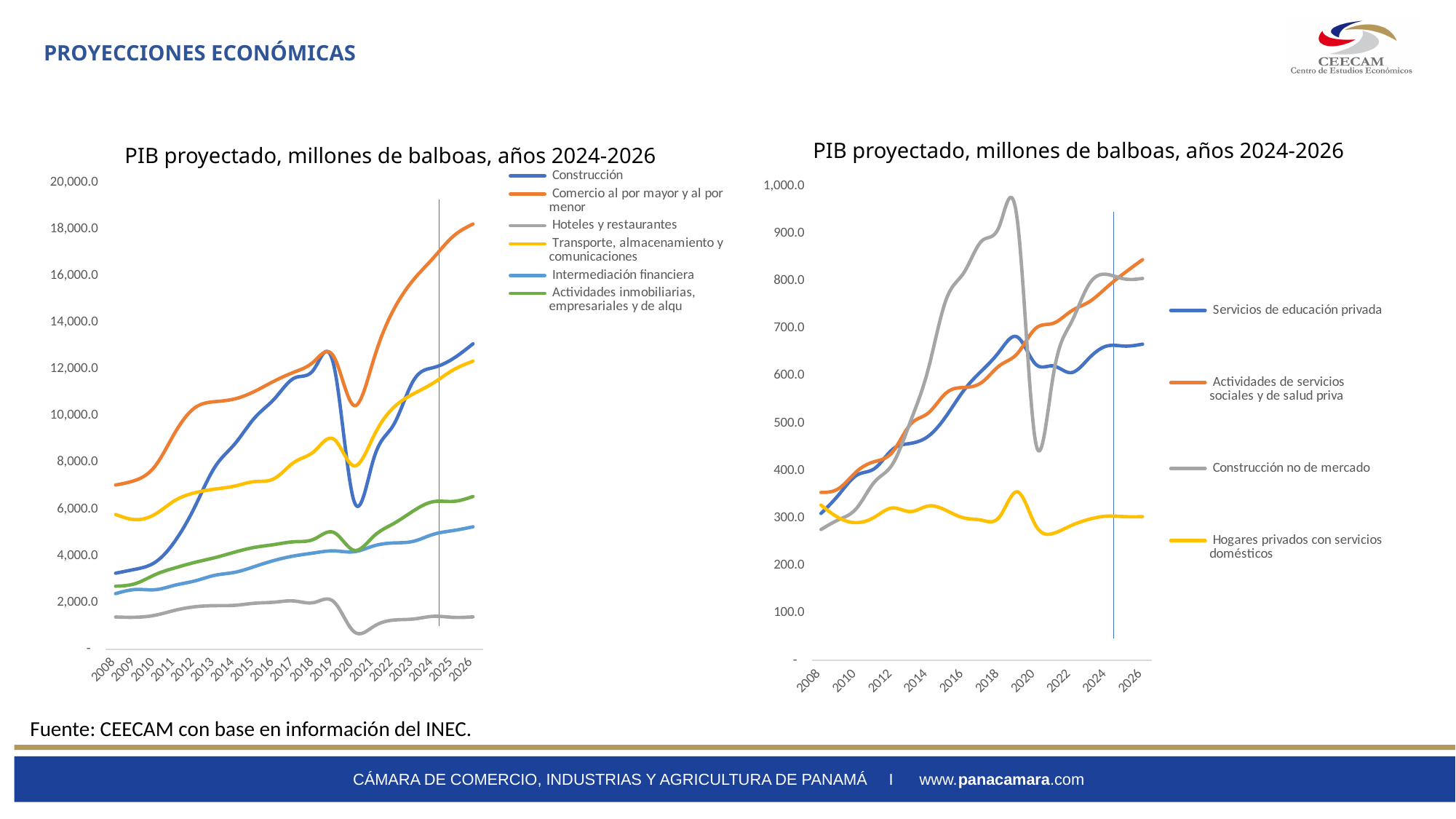
In the right chart, which series has the lowest value in 2026? Hogares privados con servicios domésticos In the left chart, is the value for Comercio al por mayor y al por menor in 2026 greater or less than 16,000.0? greater What kind of chart is the left chart on the slide? line chart How many series does the legend of the left chart list? 6 In the left chart, is the value for Hoteles y restaurantes in 2026 greater or less than 2,000.0? less In the left chart, which series has the lowest value in 2026? Hoteles y restaurantes In the right chart, does the value for Actividades de servicios sociales y de salud priva rise or fall from 2020 to 2026? rise How many series does the legend of the right chart list? 4 In the right chart, is the peak value of Construcción no de mercado around 2019 greater or less than 900.0? greater In the left chart, which series has the highest value in 2026? Comercio al por mayor y al por menor What is the title of the right chart? PIB proyectado, millones de balboas, años 2024-2026 In the left chart, how many years are shown on the x axis? 19